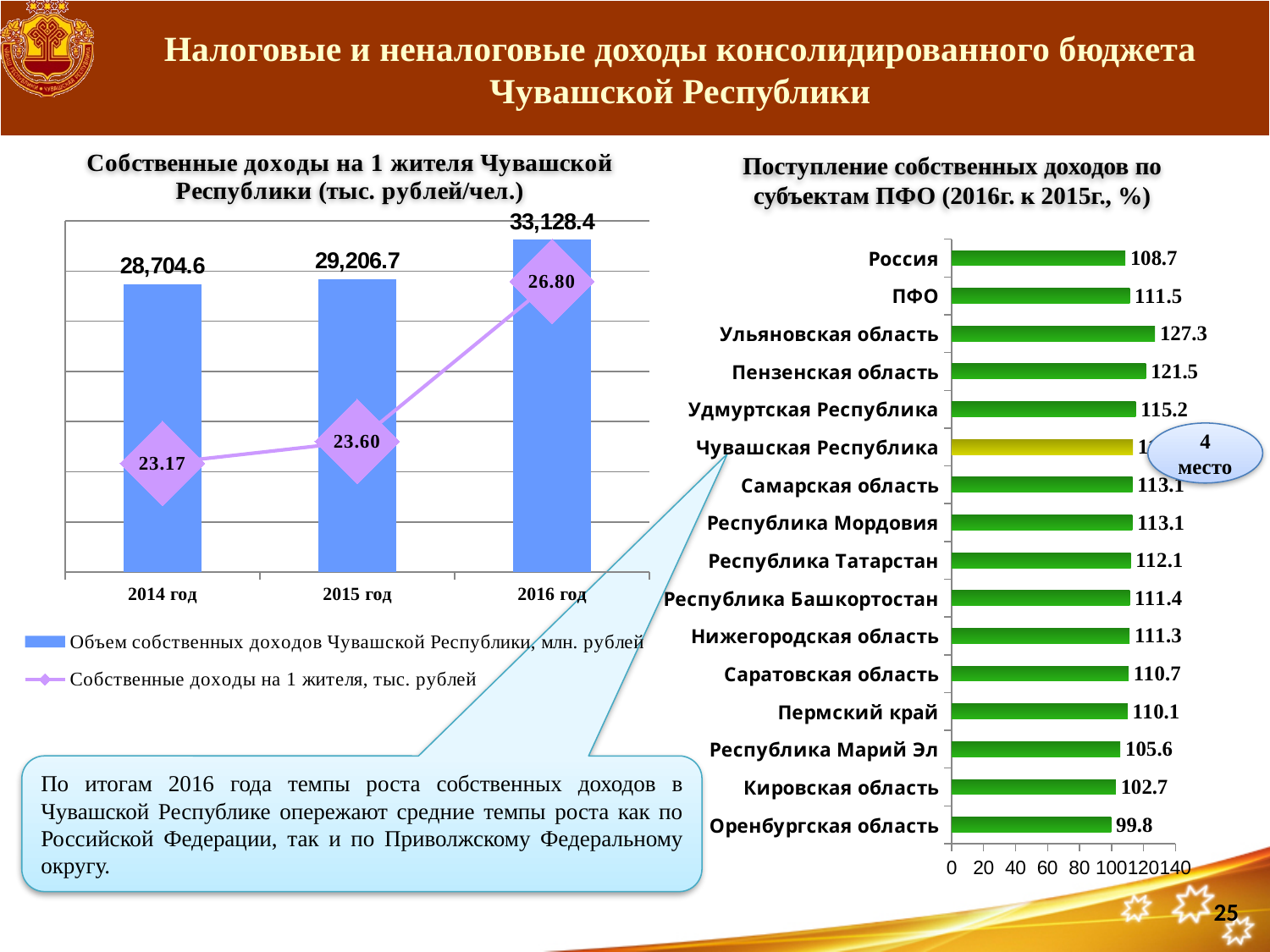
On the right chart (Поступление собственных доходов по субъектам ПФО), which region has the lowest value? Оренбургская область On the left chart, do the bar values rise or fall from 2014 год to 2016 год? rise On the left chart, what is the difference between the bar values for 2016 год and 2015 год? 3,921.7 On the left chart, what is the value of the bar for 2016 год? 33,128.4 On the right chart, how many regions (categories) are plotted? 16 On the right chart, which is larger: the value for Россия or the value for ПФО? ПФО What kind of chart is the right chart (Поступление собственных доходов по субъектам ПФО)? bar chart On the right chart, what is the value for Пензенская область? 121.5 On the left chart, how many series does the legend list? 2 On the right chart (Поступление собственных доходов по субъектам ПФО), which region has the highest value? Ульяновская область On the right chart, what is the difference between the values for Ульяновская область and Пензенская область? 5.8 On the left chart, what is the value of the line series (Собственные доходы на 1 жителя) for 2015 год? 23.60